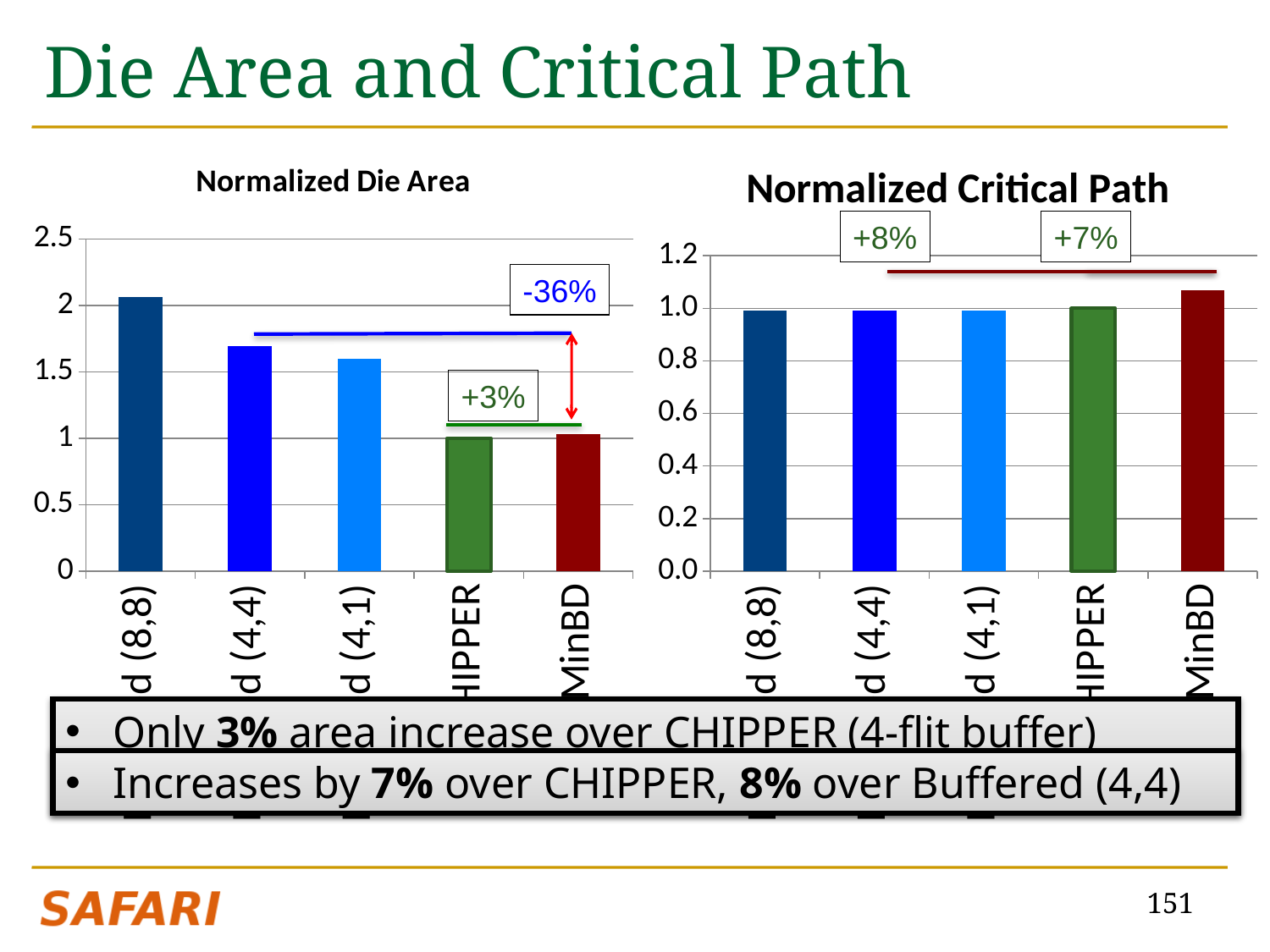
In the Normalized Critical Path chart, is the value for CHIPPER greater or less than 0.8? greater What kind of chart is the Normalized Die Area chart? bar chart In the Normalized Die Area chart, what percentage is shown in the annotation above the MinBD bar comparing it to CHIPPER? +3% How many bars are plotted in the Normalized Critical Path chart? 5 In the Normalized Die Area chart, is the value for MinBD greater or less than 1.5? less In the Normalized Die Area chart, is the value for CHIPPER greater or less than 1.5? less In the Normalized Die Area chart, what percentage is shown in the blue annotation box at the top right? -36% In the Normalized Die Area chart, which of CHIPPER and MinBD has the larger value? MinBD What is the title of the chart on the right side of the slide? Normalized Critical Path In the Normalized Critical Path chart, which category has the highest value? MinBD